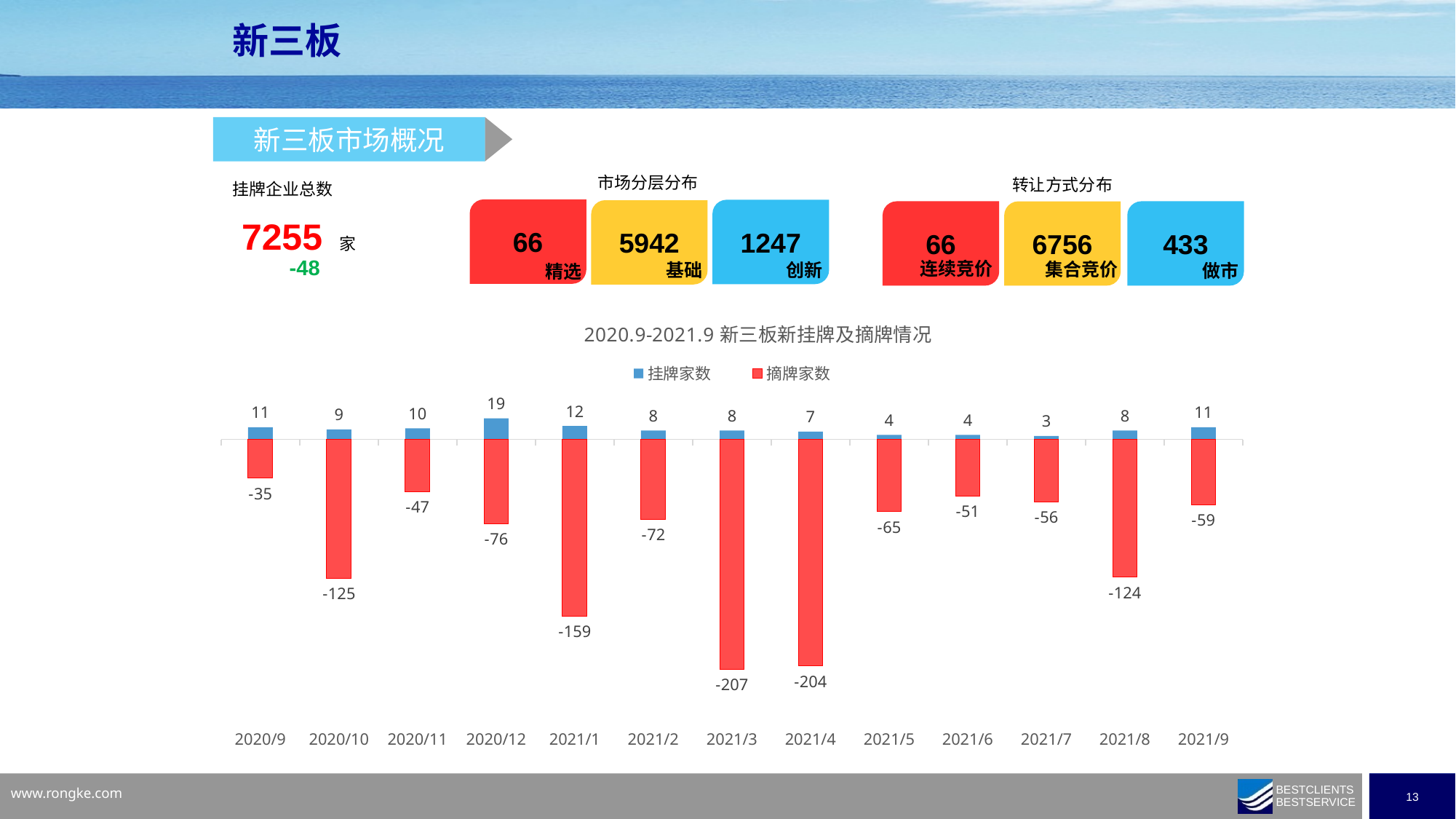
What is the difference between the 挂牌家数 for 2020/12 and 2021/7? 16 Which month has the lowest 摘牌家数 value (the largest number of delistings)? 2021/3 What is the 摘牌家数 value for 2021/8? -124 What type of chart is used to show 新挂牌及摘牌情况? bar chart Which month has the highest 挂牌家数? 2020/12 Which month has the lowest 挂牌家数? 2021/7 What is the 挂牌家数 value for 2020/12? 19 What is the title of the chart? 2020.9-2021.9 新三板新挂牌及摘牌情况 Which is larger in magnitude, the 摘牌家数 for 2020/10 or for 2021/8? 2020/10 How many series does the chart legend list? 2 What is the 摘牌家数 value for 2021/3? -207 How many months are shown on the x axis of the chart? 13